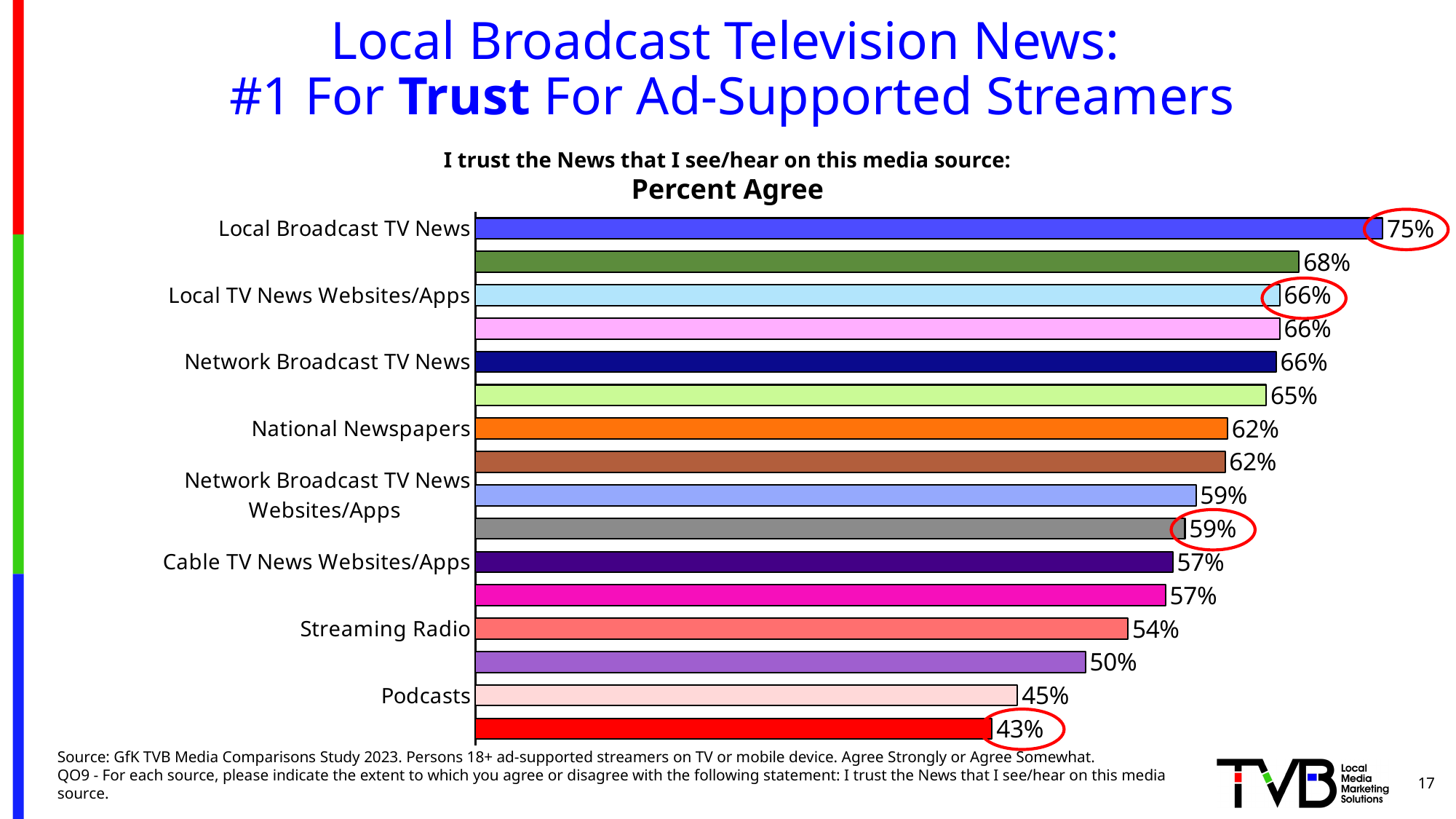
What is the difference between the values for Local Broadcast TV News and Podcasts? 30 percentage points What is the lowest value shown on the chart? 43% What is the value for Cable TV News Websites/Apps? 57% How many bars are plotted on the chart? 16 What is the value for National Newspapers? 62% Which is larger, the value for Streaming Radio or the value for Podcasts? Streaming Radio Do the bar values increase or decrease from the top of the chart to the bottom? Decrease What kind of chart is shown on the slide? Bar chart Which labeled media source has the highest percent agree? Local Broadcast TV News What is the value for Local Broadcast TV News? 75% What is the value for Streaming Radio? 54% What is the value for Podcasts? 45%